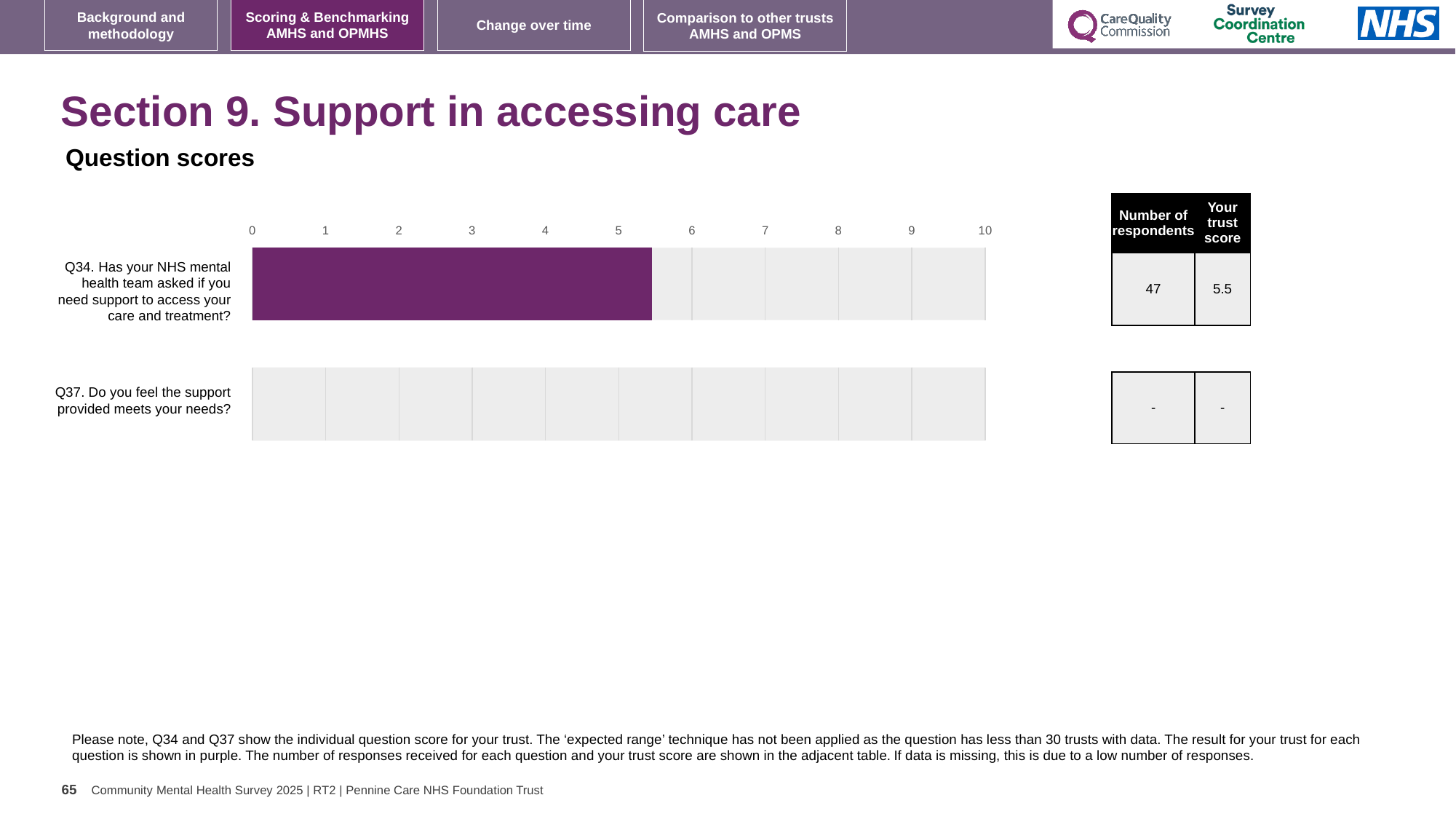
What is shown as the trust score for Q37 (Do you feel the support provided meets your needs?)? - Is the value for Q34 greater or less than 5? greater What is the trust score for Q34 (Has your NHS mental health team asked if you need support to access your care and treatment?)? 5.5 Is the value for Q34 greater or less than 6? less What kind of chart is shown on the slide? bar chart What is the number of respondents shown for Q37? - What is the maximum value shown on the chart's axis? 10 Which question on the chart has a plotted bar? Q34 How many questions are listed on the chart? 2 How many respondents answered Q34? 47